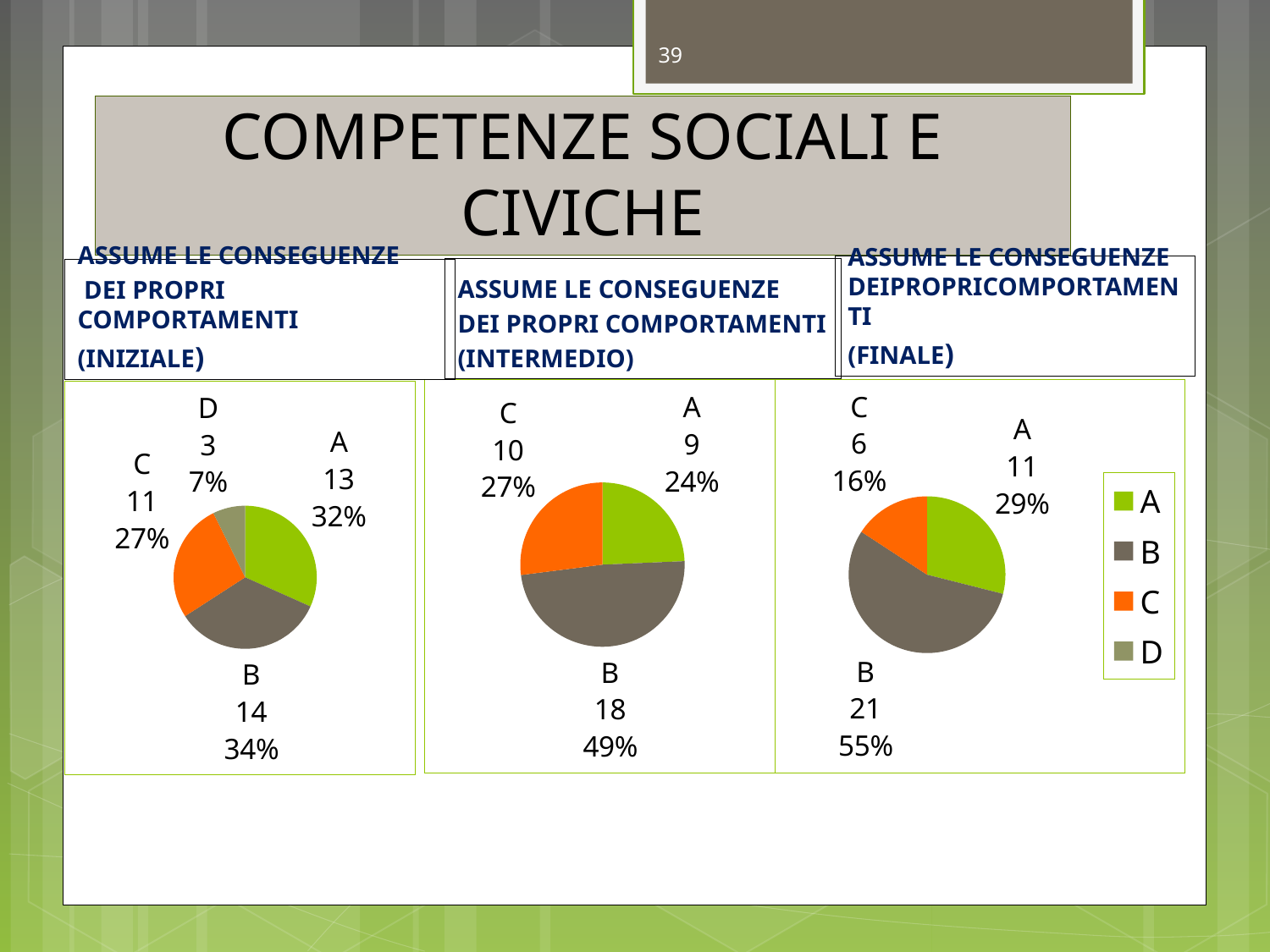
In the INTERMEDIO pie chart, what is the value for category B? 18 What type of chart is used on this slide? Pie chart In the FINALE pie chart, which is larger, the value for A or the value for C? A In the INTERMEDIO pie chart, what is the difference between the values for B and A? 9 In the FINALE pie chart, what percentage does category B represent? 55% In the INIZIALE pie chart, what percentage does category D represent? 7% In the FINALE pie chart, which category has the largest slice? B In the FINALE pie chart, what is the value for category C? 6 In the INIZIALE pie chart, what is the value for category B? 14 In the INIZIALE pie chart, which category has the smallest slice? D How many categories are shown in the INIZIALE pie chart? 4 In the INTERMEDIO pie chart, what percentage does category A represent? 24%